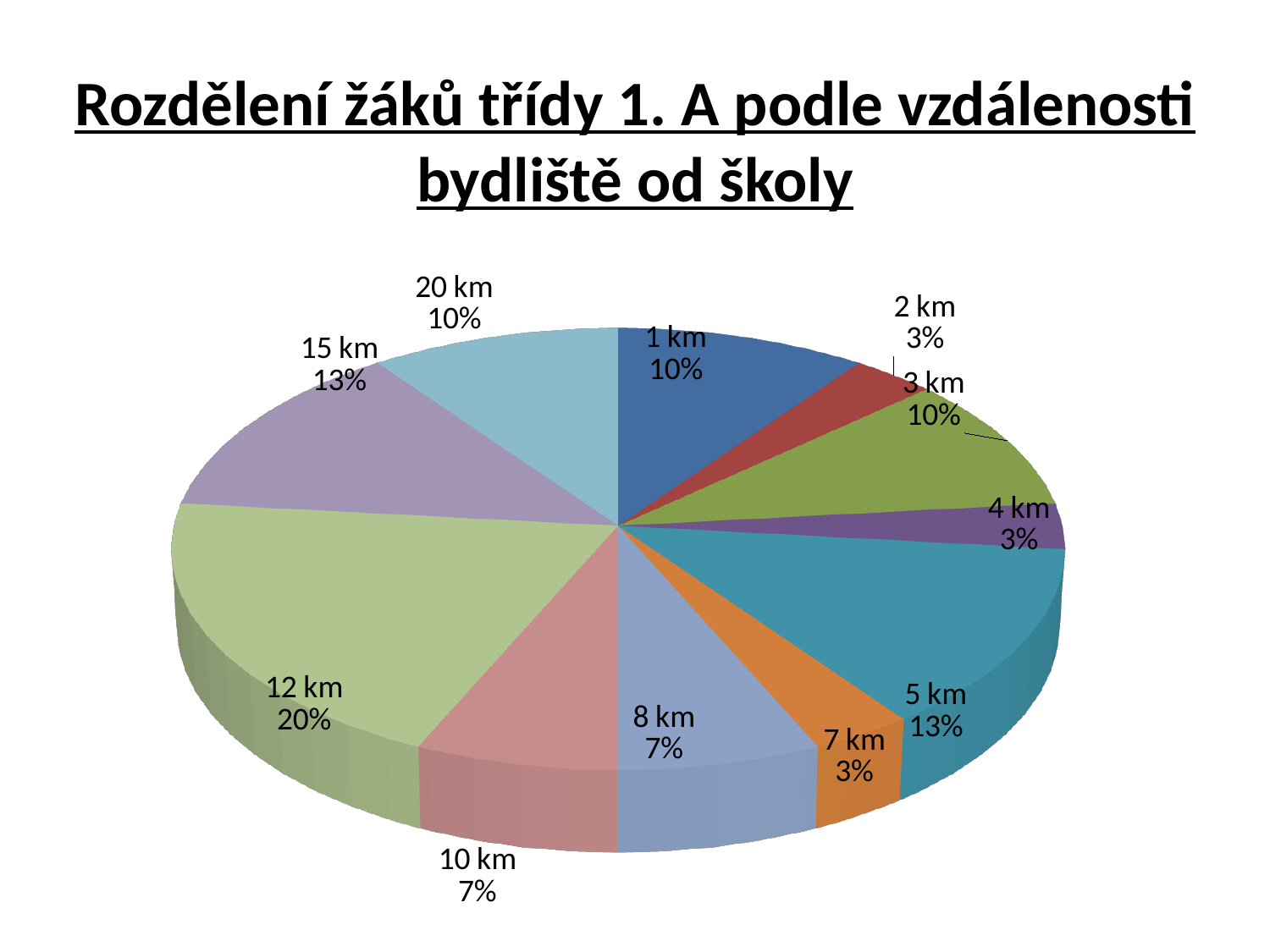
How many slices does the pie chart have? 11 What percentage is shown for the 4 km slice? 3% What percentage is shown for the 20 km slice? 10% Which distance category has the largest share of the pie? 12 km What type of chart is shown on the slide? pie chart What is the title of the chart on the slide? Rozdělení žáků třídy 1. A podle vzdálenosti bydliště od školy Which is larger, the share for 5 km or the share for 7 km? 5 km What share of the pie does the 12 km slice represent? 20% What is the difference in percentage points between the 12 km slice and the 15 km slice? 7 What is the difference in percentage points between the 1 km slice and the 2 km slice? 7 What percentage is shown for the 5 km slice? 13% What percentage is shown for the 8 km slice? 7%